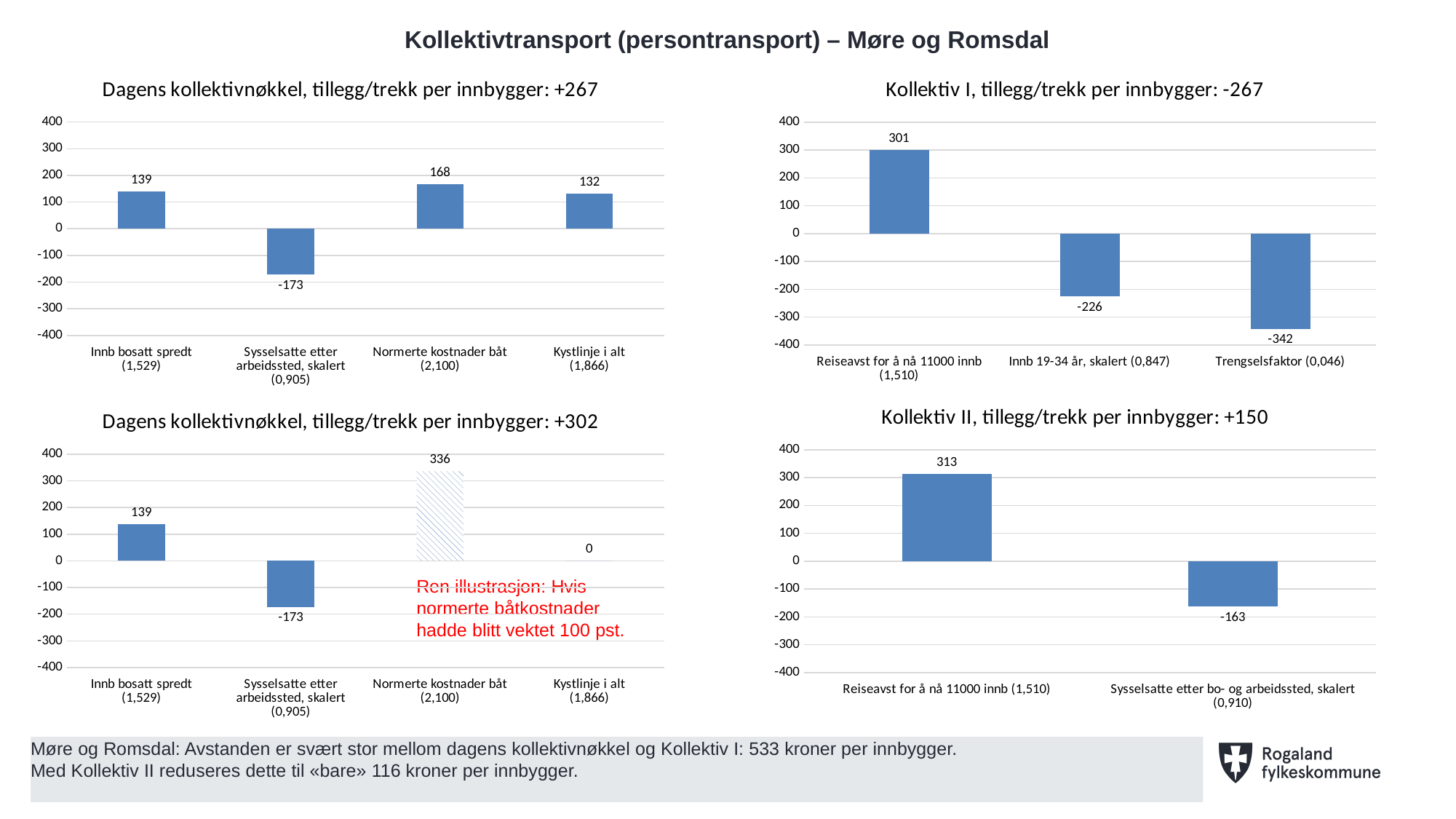
In the chart titled "Dagens kollektivnøkkel, tillegg/trekk per innbygger: +302", what is the value for Normerte kostnader båt (2,100)? 336 In the chart titled "Kollektiv I, tillegg/trekk per innbygger: -267", what is the value for Trengselsfaktor (0,046)? -342 In the chart titled "Kollektiv II, tillegg/trekk per innbygger: +150", how many categories are shown? 2 In the chart titled "Kollektiv I, tillegg/trekk per innbygger: -267", which category has the highest value? Reiseavst for å nå 11000 innb (1,510) In the chart titled "Kollektiv II, tillegg/trekk per innbygger: +150", what is the value for Sysselsatte etter bo- og arbeidssted, skalert (0,910)? -163 In the chart titled "Dagens kollektivnøkkel, tillegg/trekk per innbygger: +267", what is the value for Normerte kostnader båt (2,100)? 168 In the chart titled "Dagens kollektivnøkkel, tillegg/trekk per innbygger: +267", how many categories are shown? 4 In the chart titled "Kollektiv I, tillegg/trekk per innbygger: -267", what is the difference between the value for Reiseavst for å nå 11000 innb (1,510) and the value for Innb 19-34 år, skalert (0,847)? 527 What kind of chart is the chart titled "Kollektiv I, tillegg/trekk per innbygger: -267"? Bar chart In the chart titled "Dagens kollektivnøkkel, tillegg/trekk per innbygger: +302", what is the value for Kystlinje i alt (1,866)? 0 Which is larger: the value for Reiseavst for å nå 11000 innb (1,510) in the "Kollektiv I" chart or in the "Kollektiv II" chart? Kollektiv II In the chart titled "Dagens kollektivnøkkel, tillegg/trekk per innbygger: +267", which category has the lowest value? Sysselsatte etter arbeidssted, skalert (0,905)